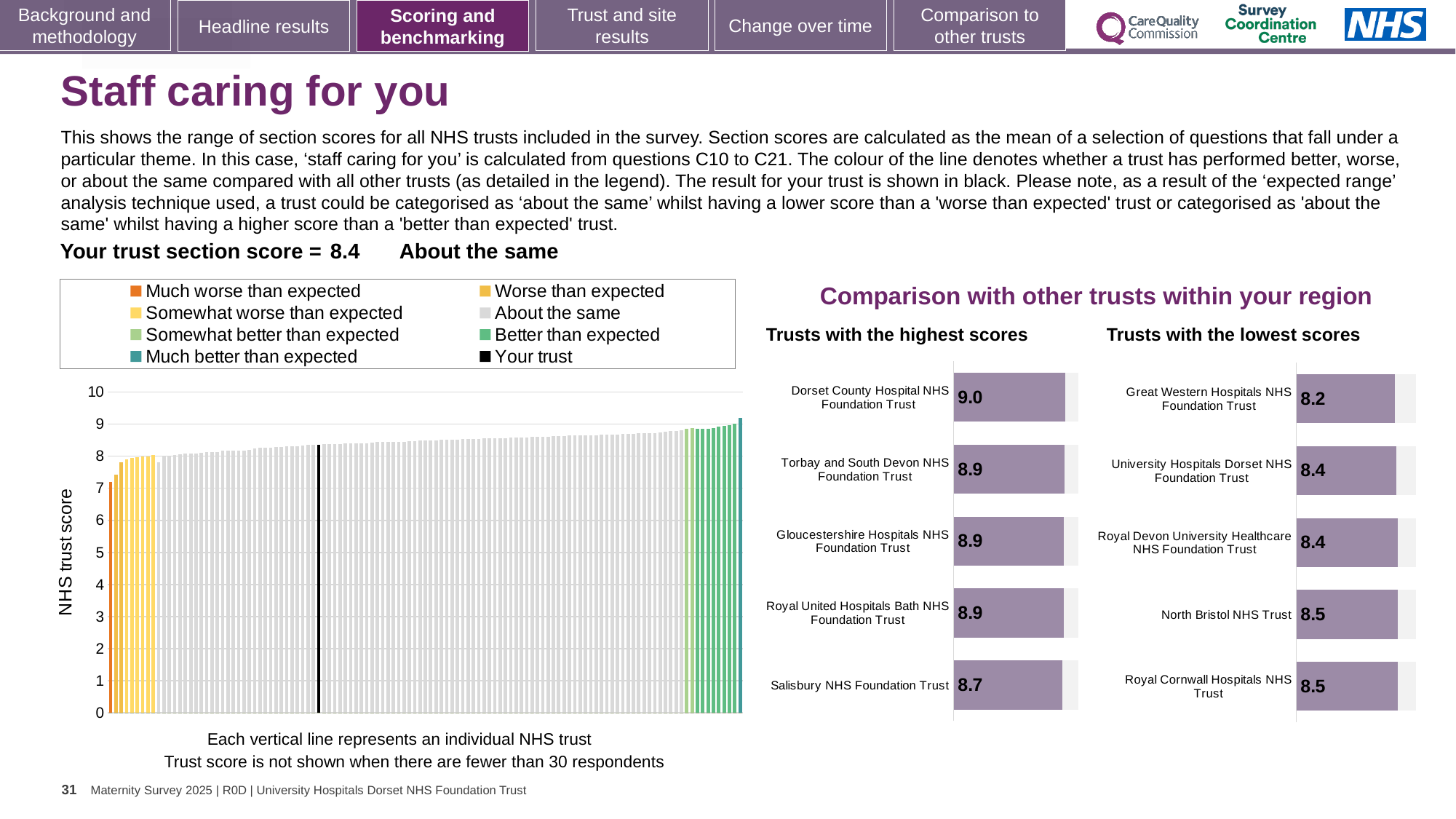
How many entries does the legend above the large 'NHS trust score' chart list? 8 In the 'Trusts with the highest scores' chart, what is the score for Salisbury NHS Foundation Trust? 8.7 In the large 'NHS trust score' chart on the left, is the value for your trust (the black line) greater or less than 8? greater How many trusts are shown in the 'Trusts with the highest scores' chart? 5 In the 'Trusts with the highest scores' chart, what is the difference between the scores of Dorset County Hospital NHS Foundation Trust and Salisbury NHS Foundation Trust? 0.3 In the 'Trusts with the lowest scores' chart, which trust has the lowest score? Great Western Hospitals NHS Foundation Trust In the large 'NHS trust score' chart on the left, do the trust scores rise or fall from left to right along the x axis? rise In the 'Trusts with the lowest scores' chart, what is the score for Great Western Hospitals NHS Foundation Trust? 8.2 In the 'Trusts with the highest scores' chart, what is the score for Dorset County Hospital NHS Foundation Trust? 9.0 In the 'Trusts with the lowest scores' chart, which has the larger score: Great Western Hospitals NHS Foundation Trust or North Bristol NHS Trust? North Bristol NHS Trust In the 'Trusts with the lowest scores' chart, what is the score for North Bristol NHS Trust? 8.5 In the 'Trusts with the highest scores' chart, which trust has the highest score? Dorset County Hospital NHS Foundation Trust